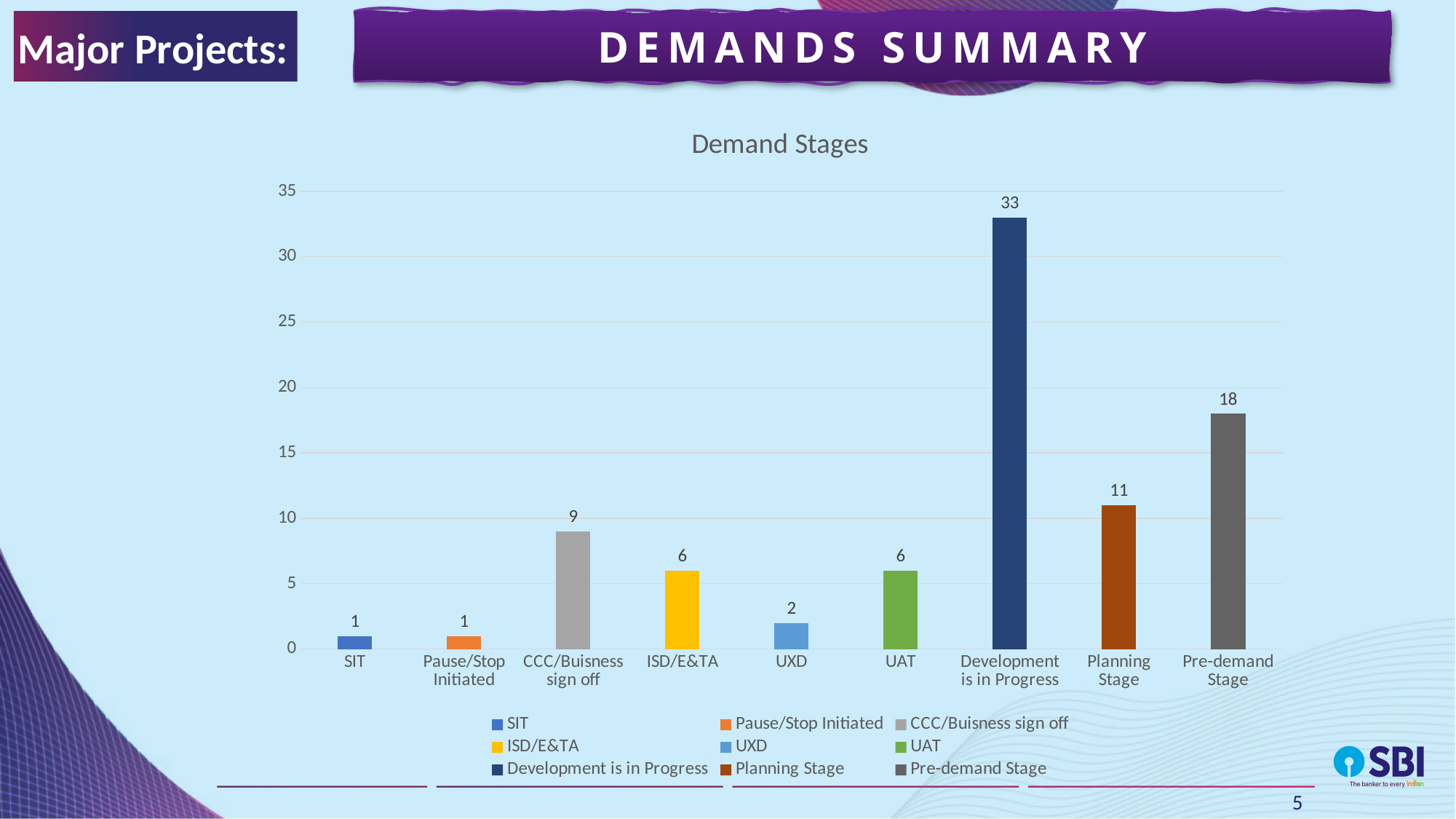
What kind of chart is shown? bar chart What is the difference between Development is in Progress and Pre-demand Stage? 15 How many categories are shown on the x axis? 9 What is the difference between Planning Stage and CCC/Buisness sign off? 2 What is the title of the chart? Demand Stages Is the value for Development is in Progress greater or less than 30? greater What is the value for CCC/Buisness sign off? 9 What is the value for Development is in Progress? 33 What is the value for UXD? 2 Which category has the highest value? Development is in Progress What is the value for Pre-demand Stage? 18 Which is larger, Planning Stage or Pre-demand Stage? Pre-demand Stage